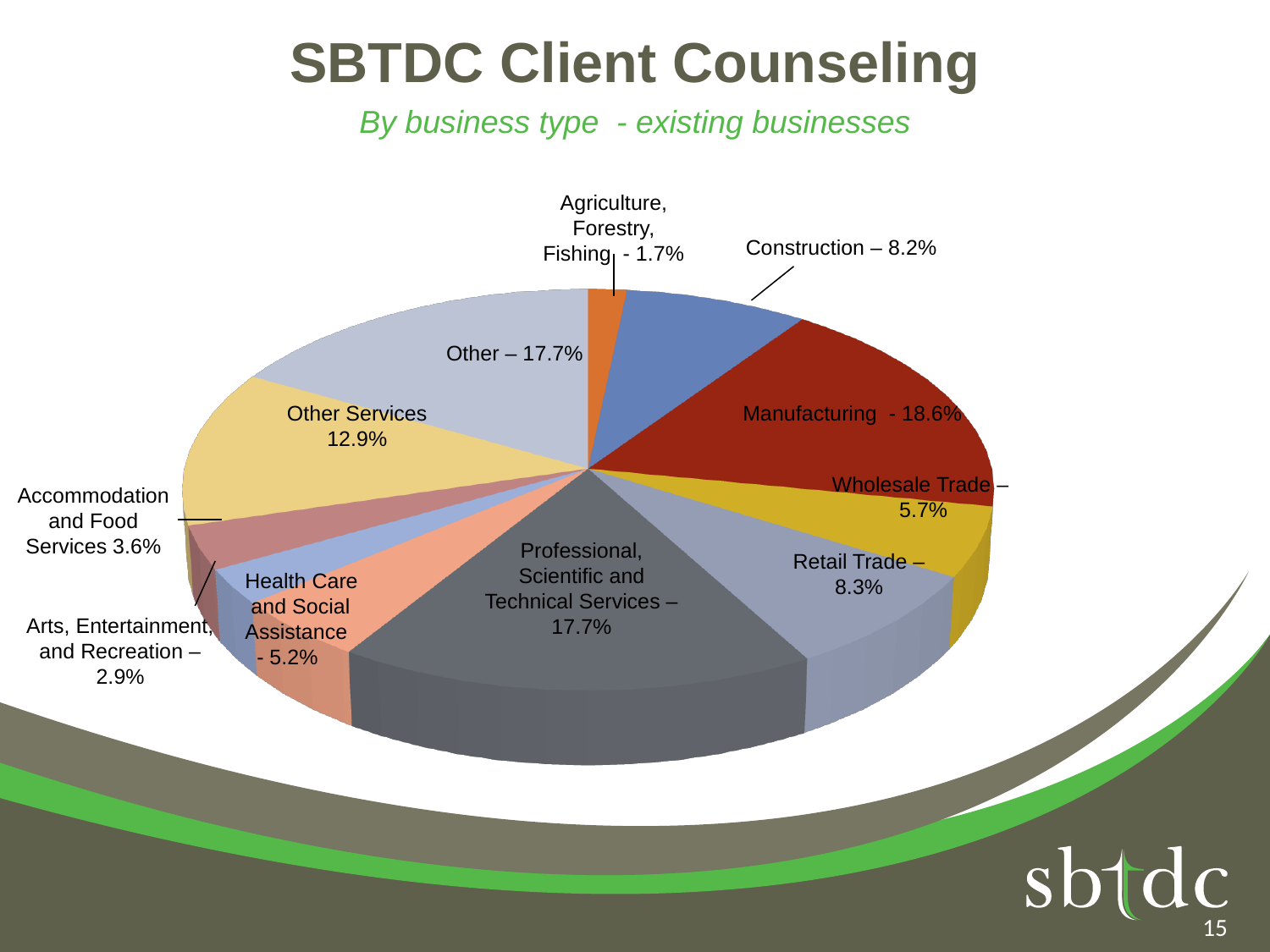
How many business types (slices) are shown in the pie chart? 11 What type of chart is shown on the slide? Pie chart What is the difference in percentage points between Other and Health Care and Social Assistance? 12.5 What share of the pie does Manufacturing represent? 18.6% What percentage is shown for Professional, Scientific and Technical Services? 17.7% What is the title of the chart on the slide? SBTDC Client Counseling Which business type has the smallest share of the pie? Agriculture, Forestry, Fishing Which is larger, the share for Other Services or the share for Construction? Other Services What percentage is shown for Health Care and Social Assistance? 5.2% Which business type has the largest share of the pie? Manufacturing What is the difference in percentage points between Manufacturing and Other Services? 5.7 What percentage is shown for Wholesale Trade? 5.7%